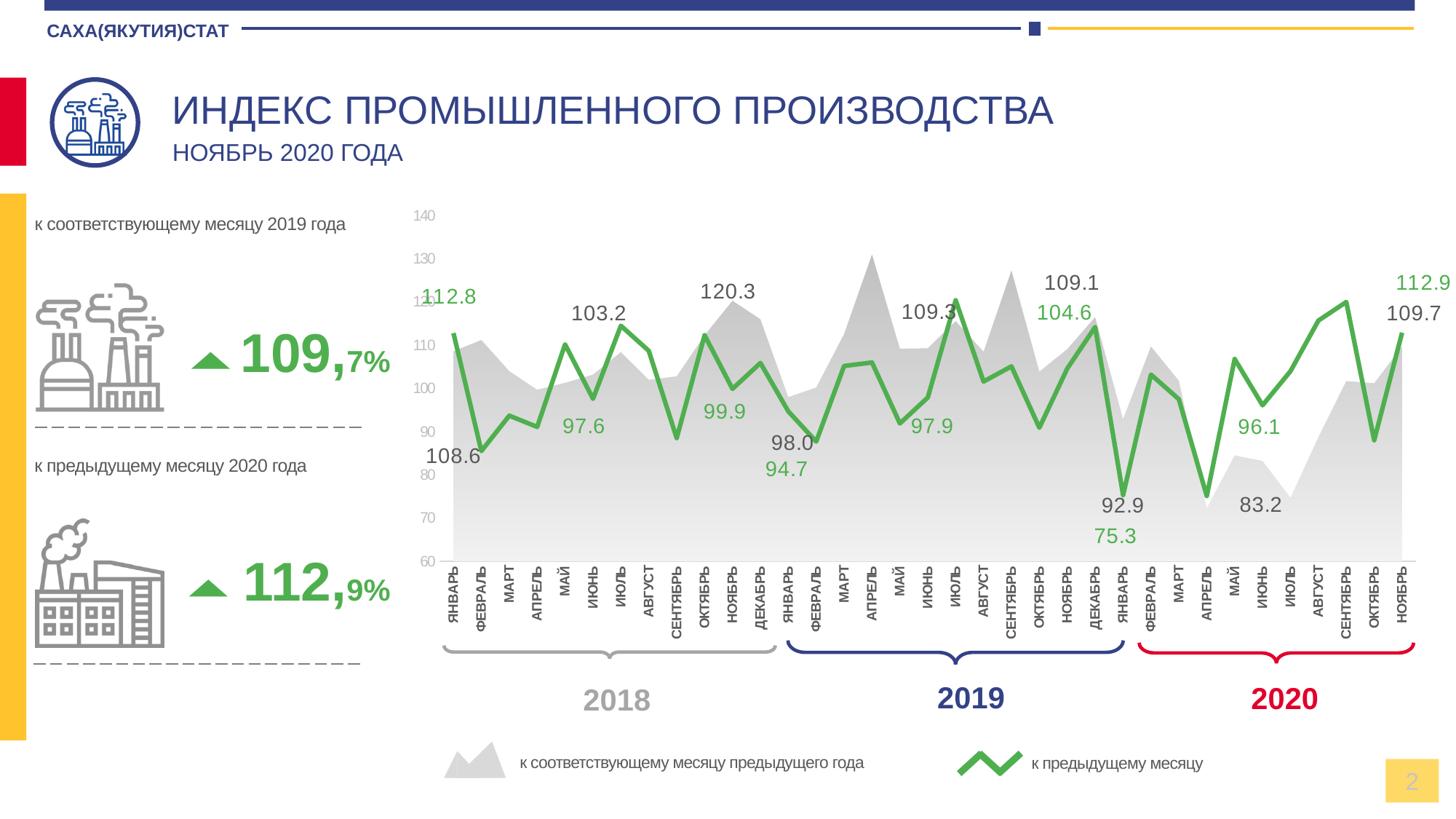
Is the value of the grey series for April 2019 greater or less than 120? greater How many series does the chart legend list? 2 Is the value of the green line for September 2020 greater or less than 110? greater What colour is the series 'к предыдущему месяцу' drawn in? green How many months are shown on the x axis of the chart? 35 What is the lowest labelled value of the green line 'к предыдущему месяцу'? 75.3 For November 2020, which series has the larger value: 'к предыдущему месяцу' or 'к соответствующему месяцу предыдущего года'? к предыдущему месяцу Which years are marked by the brackets under the x axis? 2018, 2019, 2020 What is the value of the green line 'к предыдущему месяцу' for November 2020? 112.9 What is the difference between the two series' values for November 2020 (112.9 and 109.7)? 3.2 What is the value of the grey series 'к соответствующему месяцу предыдущего года' for November 2020? 109.7 What kind of chart is used for the series 'к предыдущему месяцу'? line chart